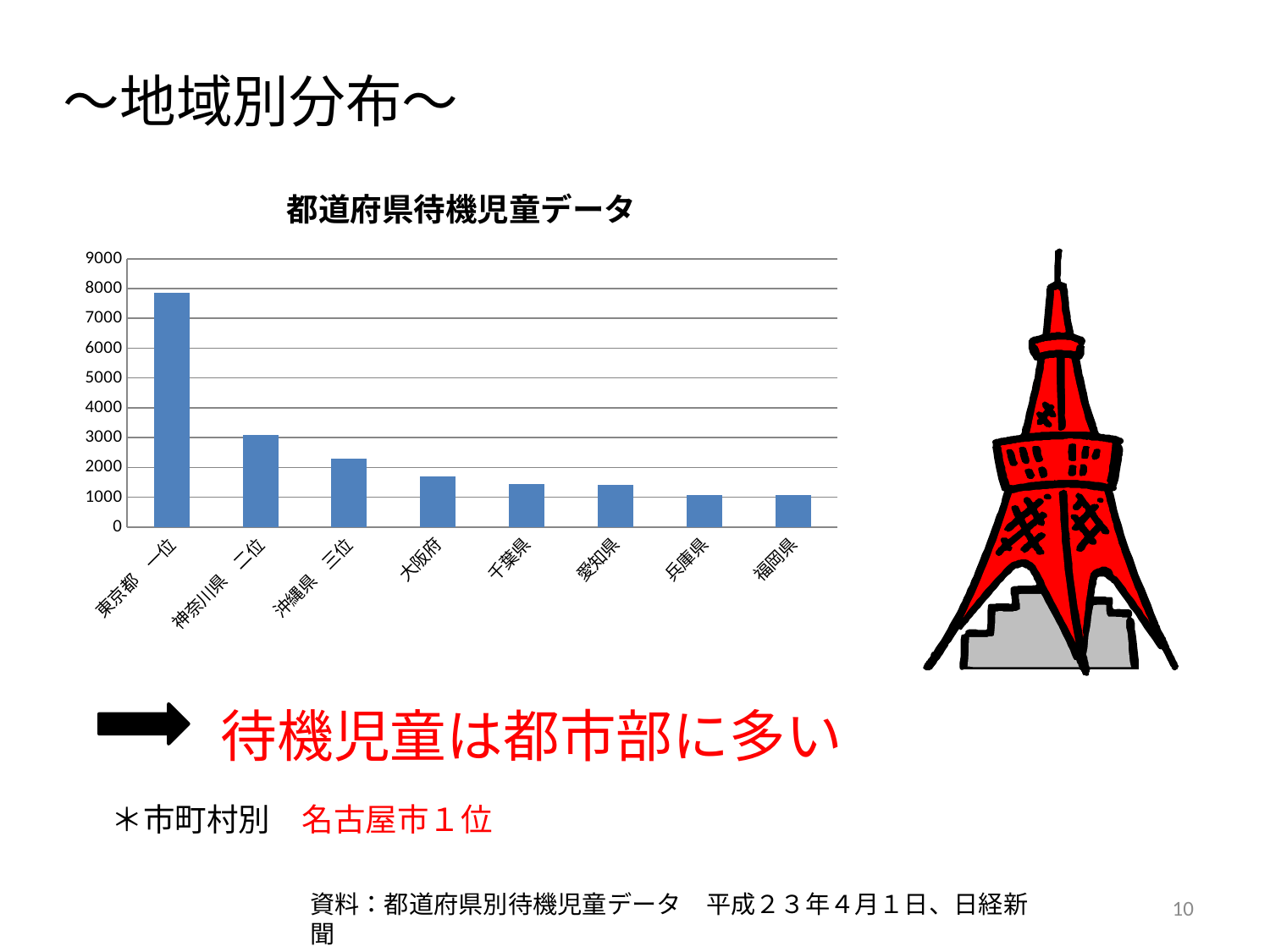
Which has a larger value, 東京都 or 神奈川県? 東京都 How many prefectures (categories) are plotted in the chart? 8 What kind of chart is shown on the slide? bar chart Which has a larger value, 沖縄県 or 大阪府? 沖縄県 Is the value for 大阪府 greater or less than 2000? less Is the value for 兵庫県 greater or less than 2000? less Is the value for 沖縄県 greater or less than 2000? greater Which prefecture has the highest value in the chart? 東京都 Do the values rise or fall moving from left to right along the x axis? fall What is the title of the chart? 都道府県待機児童データ